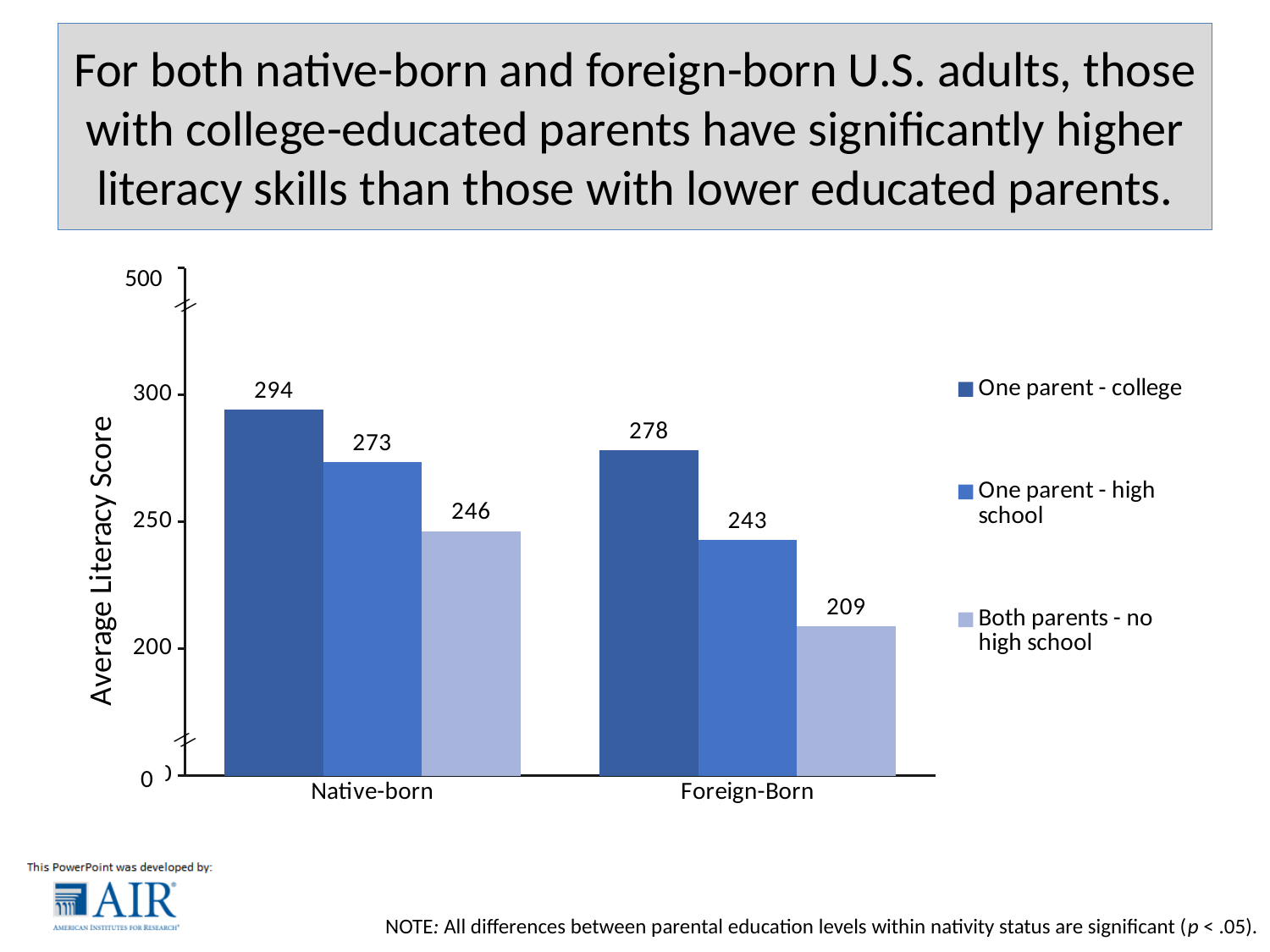
Which group has the lowest average literacy score on the chart? Foreign-Born, Both parents - no high school What is the average literacy score for native-born adults with one parent who attended college? 294 What is the average literacy score for foreign-born adults with both parents having no high school education? 209 What is the average literacy score for foreign-born adults with one parent who attended high school? 243 What kind of chart is shown on the slide? Bar chart How many series does the legend list? 3 How many nativity categories are shown on the x axis? 2 What is the difference in average literacy score between foreign-born adults with one parent - college and foreign-born adults with one parent - high school? 35 What is the difference in average literacy score between native-born adults with one parent - college and native-born adults with both parents - no high school? 48 Which group has the highest average literacy score on the chart? Native-born, One parent - college Which is larger: the score for native-born adults with one parent - high school or foreign-born adults with one parent - college? Foreign-born adults with one parent - college What is the label of the y axis? Average Literacy Score